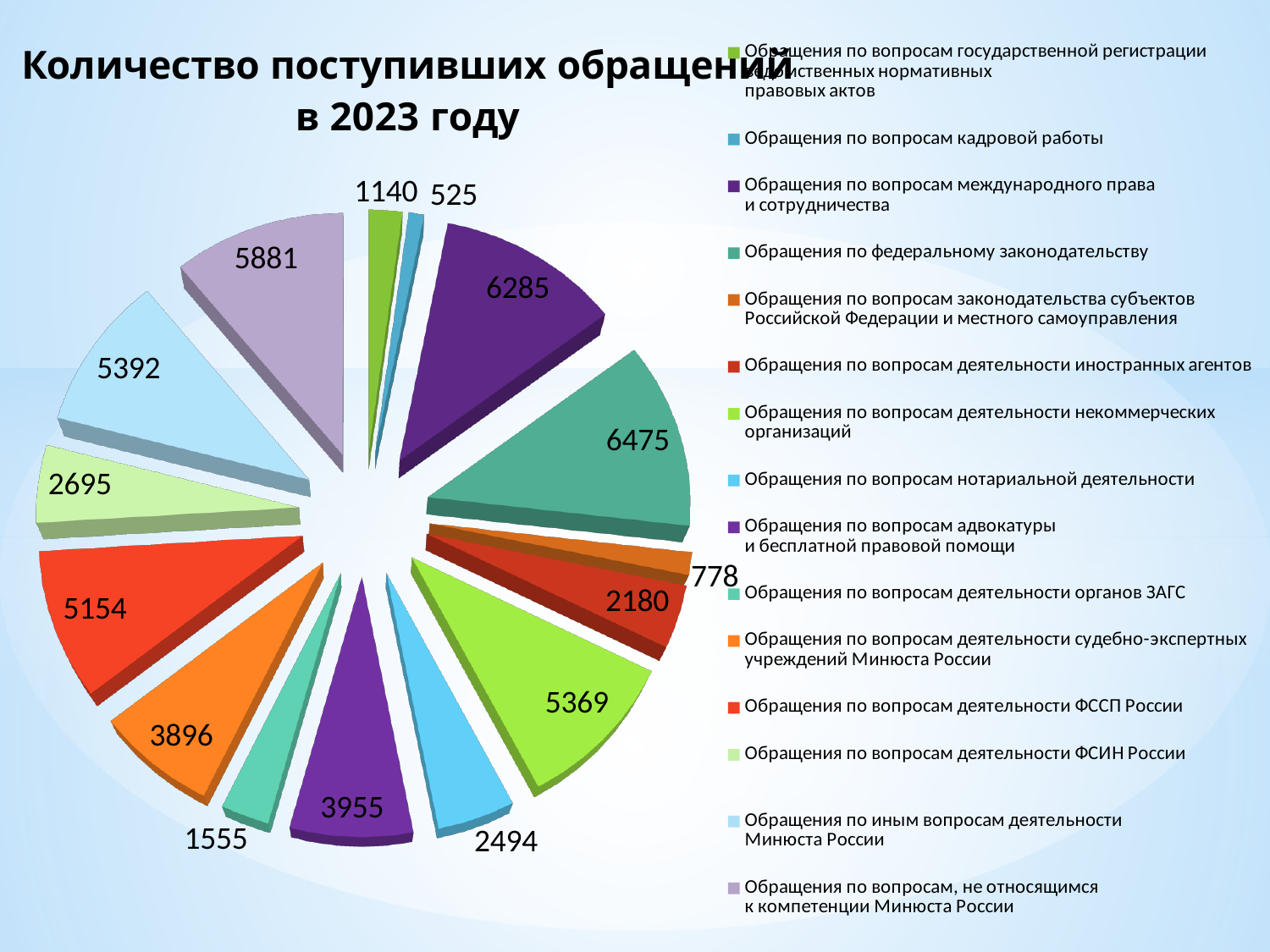
What is the value for "Обращения по вопросам кадровой работы"? 525 What is the value for "Обращения по вопросам деятельности ФССП России"? 5154 What is the title of the chart? Количество поступивших обращений в 2023 году What is the value for "Обращения по вопросам международного права и сотрудничества"? 6285 What is the difference between the values for "Обращения по вопросам деятельности некоммерческих организаций" (5369) and "Обращения по вопросам нотариальной деятельности" (2494)? 2875 Which category has the highest value? Обращения по федеральному законодательству What is the value for "Обращения по федеральному законодательству"? 6475 What type of chart is shown on the slide? pie chart How many slices does the pie chart have? 15 Which category has the lowest value? Обращения по вопросам кадровой работы What is the value for "Обращения по вопросам деятельности органов ЗАГС"? 1555 Which is larger: the value for "Обращения по вопросам, не относящимся к компетенции Минюста России" or for "Обращения по иным вопросам деятельности Минюста России"? Обращения по вопросам, не относящимся к компетенции Минюста России